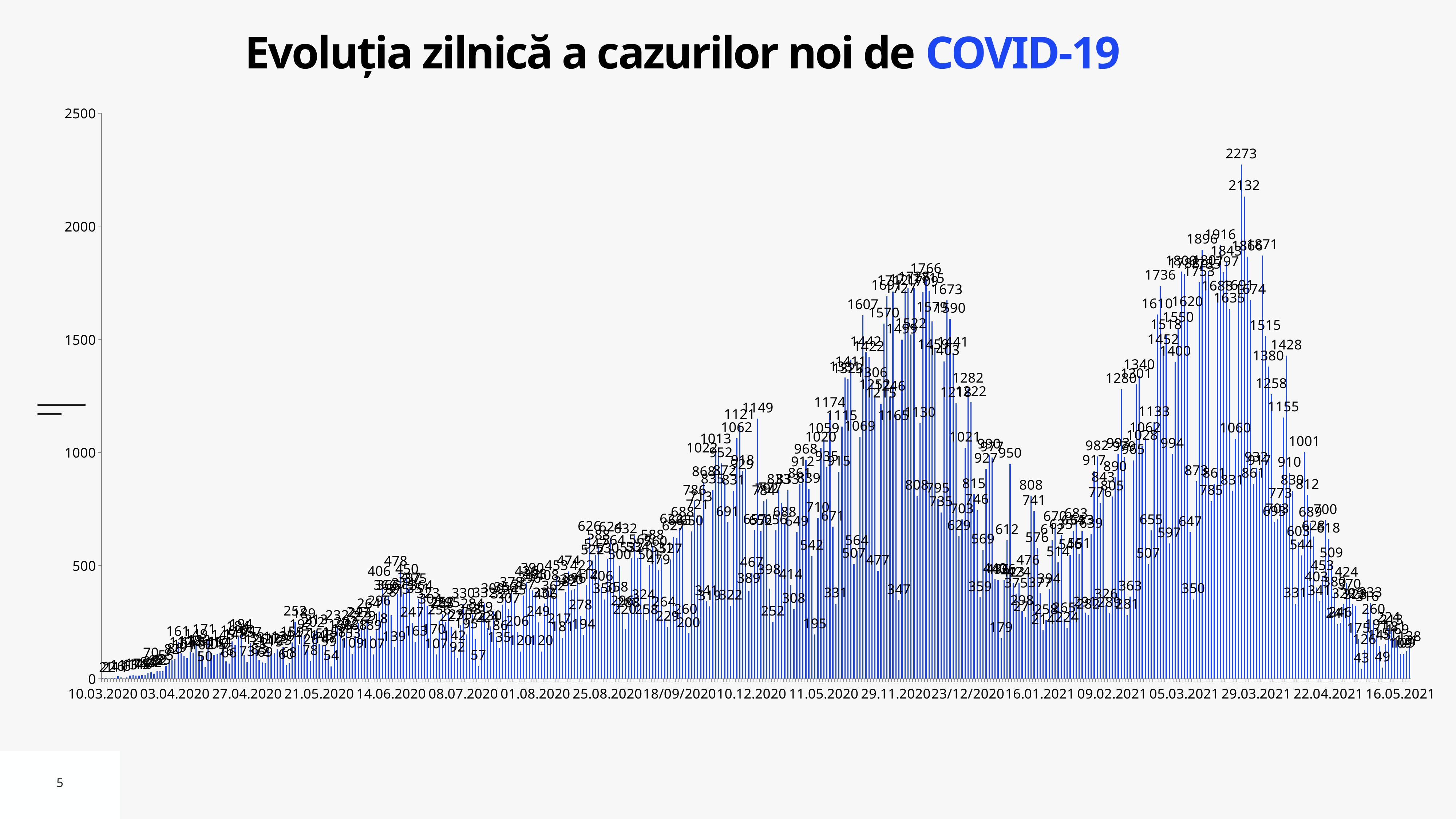
What is the highest daily value labelled on the chart? 2273 What kind of chart is shown on the slide? bar chart What is the second-highest daily value labelled on the chart, next to the 2273 peak? 2132 What is the difference between the two highest labelled values, 2273 and 2132? 141 Do the daily values rise or fall from 10.03.2020 through to 14.06.2020? rise What is the last date label shown on the horizontal axis? 16.05.2021 What is the title of the chart? Evoluția zilnică a cazurilor noi de COVID-19 Is the highest bar on the chart greater or less than 2000? greater Which is larger, the peak value 2273 or the neighbouring value 2132? 2273 Is the peak of the late-2020 wave (1766) greater or less than 1500? greater What is the maximum value shown on the vertical axis? 2500 What is the highest value labelled during the late-2020 wave (around 29.11.2020)? 1766